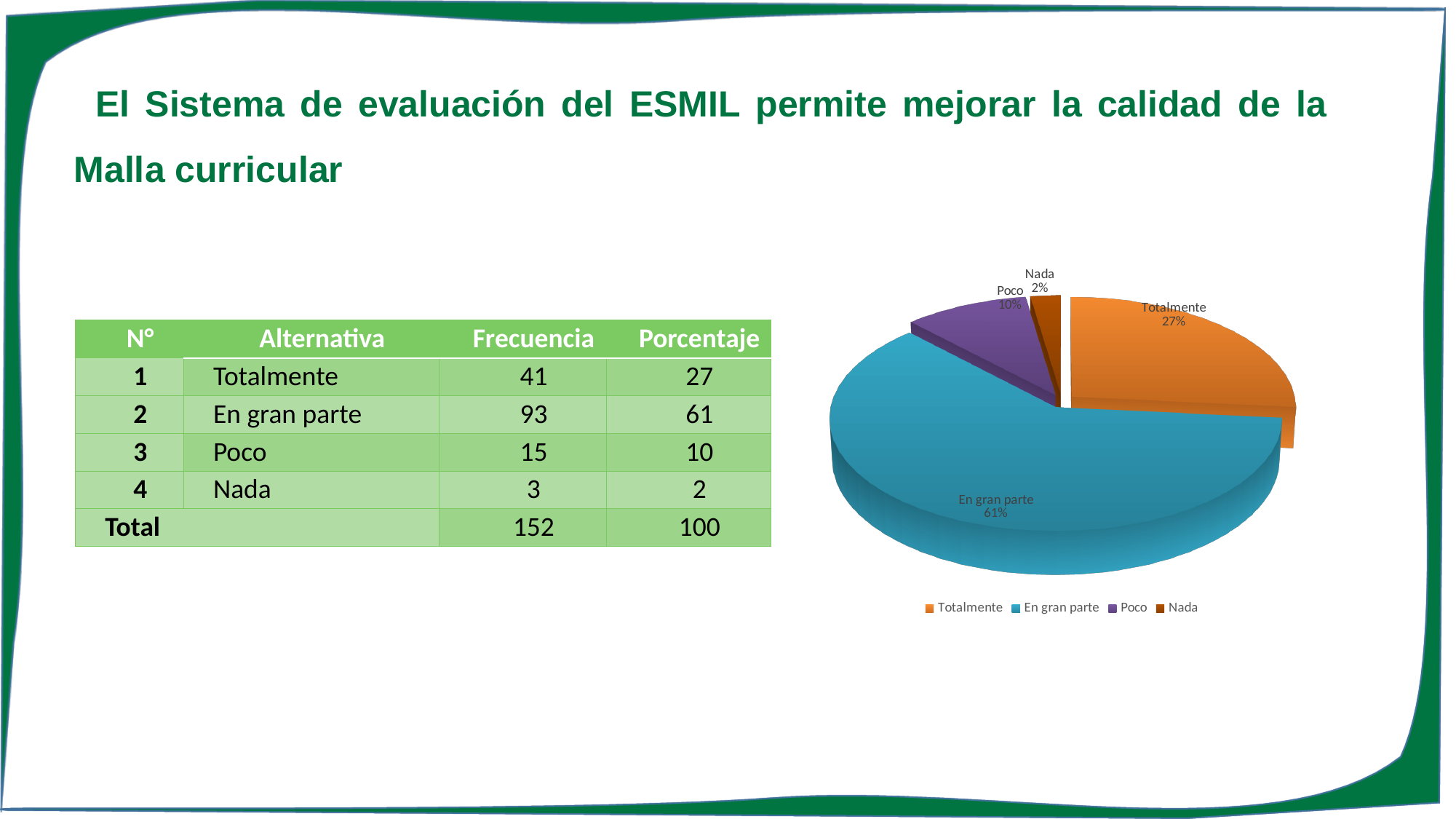
How many entries does the legend list? 4 What is the difference in percentage points between the En gran parte slice and the Totalmente slice? 34 What type of chart is shown on the slide? pie chart Which slice is larger, Totalmente or Poco? Totalmente What share of the pie does Totalmente represent? 27% What share of the pie does Nada represent? 2% How many slices does the pie chart have? 4 What share of the pie does En gran parte represent? 61% What colour is the En gran parte slice in the pie chart? blue Which category has the largest slice of the pie? En gran parte Which category has the smallest slice of the pie? Nada